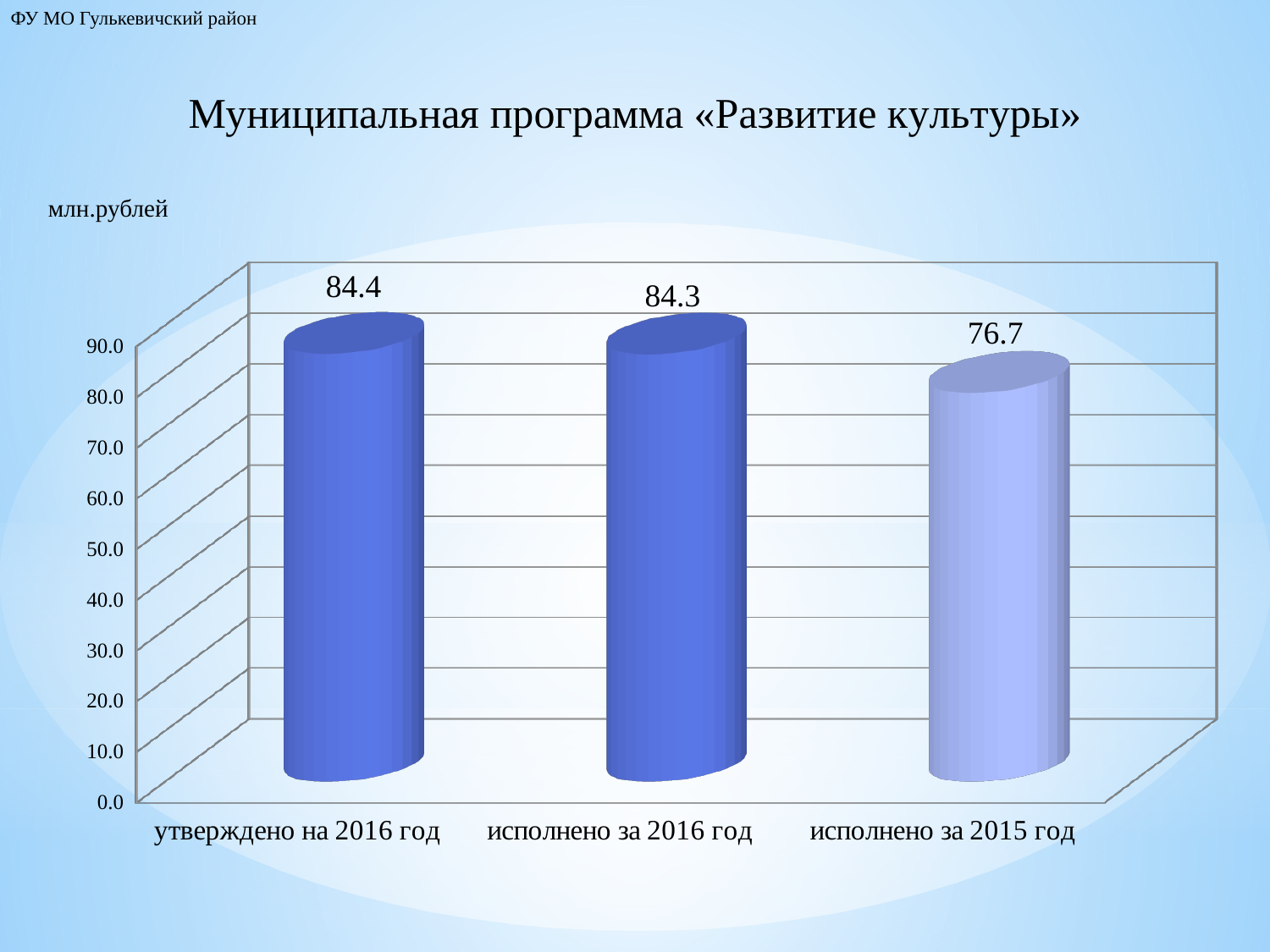
What is the value for «исполнено за 2016 год»? 84.3 How many categories are shown in the chart? 3 What is the difference between «исполнено за 2016 год» and «исполнено за 2015 год»? 7.6 What kind of chart is shown on the slide? bar chart Which is larger: «исполнено за 2016 год» or «исполнено за 2015 год»? исполнено за 2016 год What is the value for «утверждено на 2016 год»? 84.4 Is the value for «исполнено за 2015 год» greater or less than 70.0? greater What unit of measurement is indicated for the chart values? млн.рублей Which category has the lowest value? исполнено за 2015 год What is the difference between «утверждено на 2016 год» and «исполнено за 2015 год»? 7.7 Which category has the highest value? утверждено на 2016 год What is the value for «исполнено за 2015 год»? 76.7